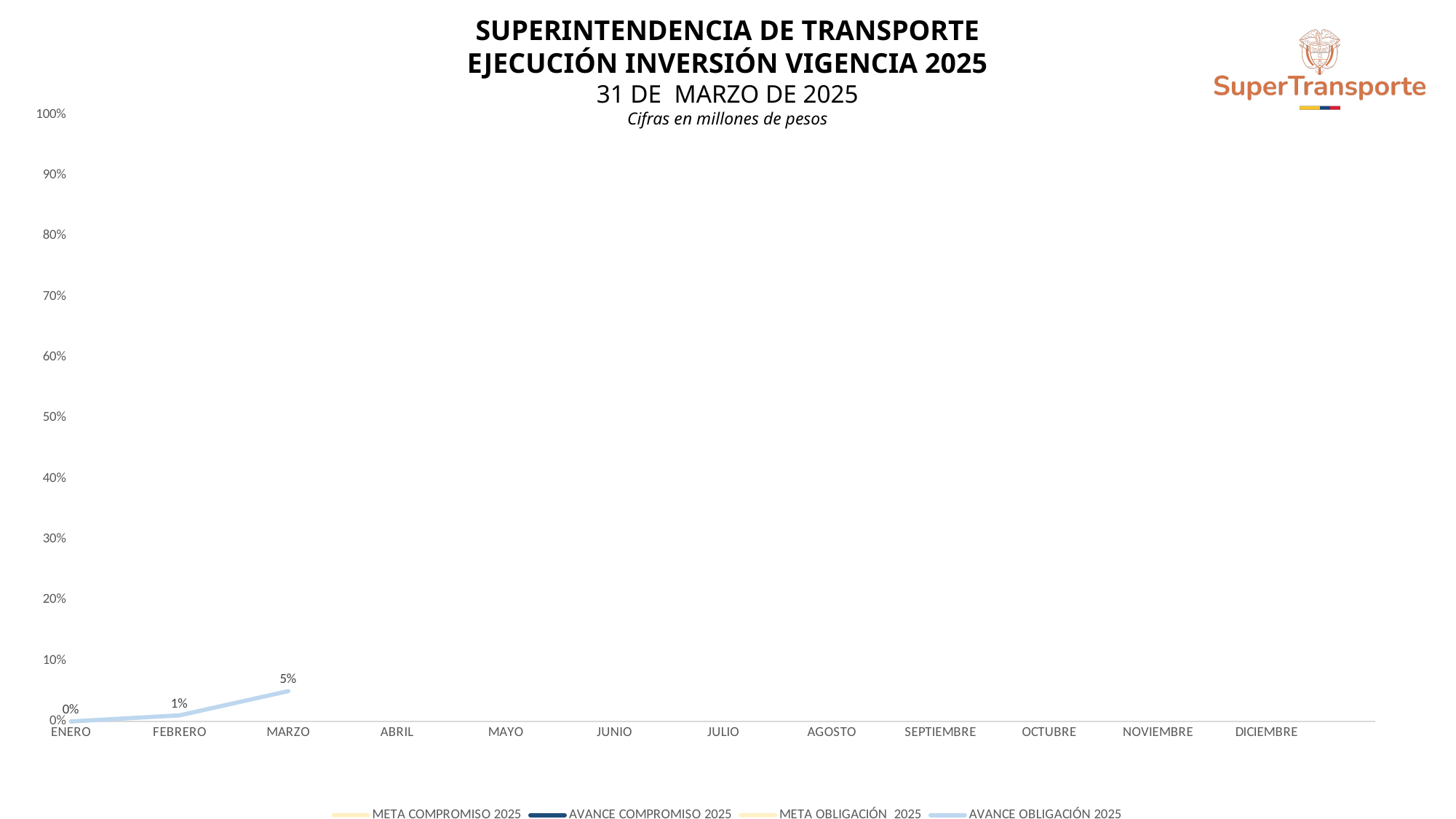
What is the value plotted for ENERO? 0% How many months are shown on the x axis? 12 What is the date shown in the chart title? 31 DE MARZO DE 2025 Which is larger, the value for FEBRERO or the value for MARZO? MARZO Is the value for MARZO greater or less than 10%? less What type of chart is shown on the slide? line chart Do the plotted values rise or fall from ENERO to MARZO? rise What is the value plotted for MARZO? 5% What is the difference between the values for MARZO and FEBRERO? 4% Which month has the highest plotted value? MARZO How many series does the legend list? 4 What is the value plotted for FEBRERO? 1%